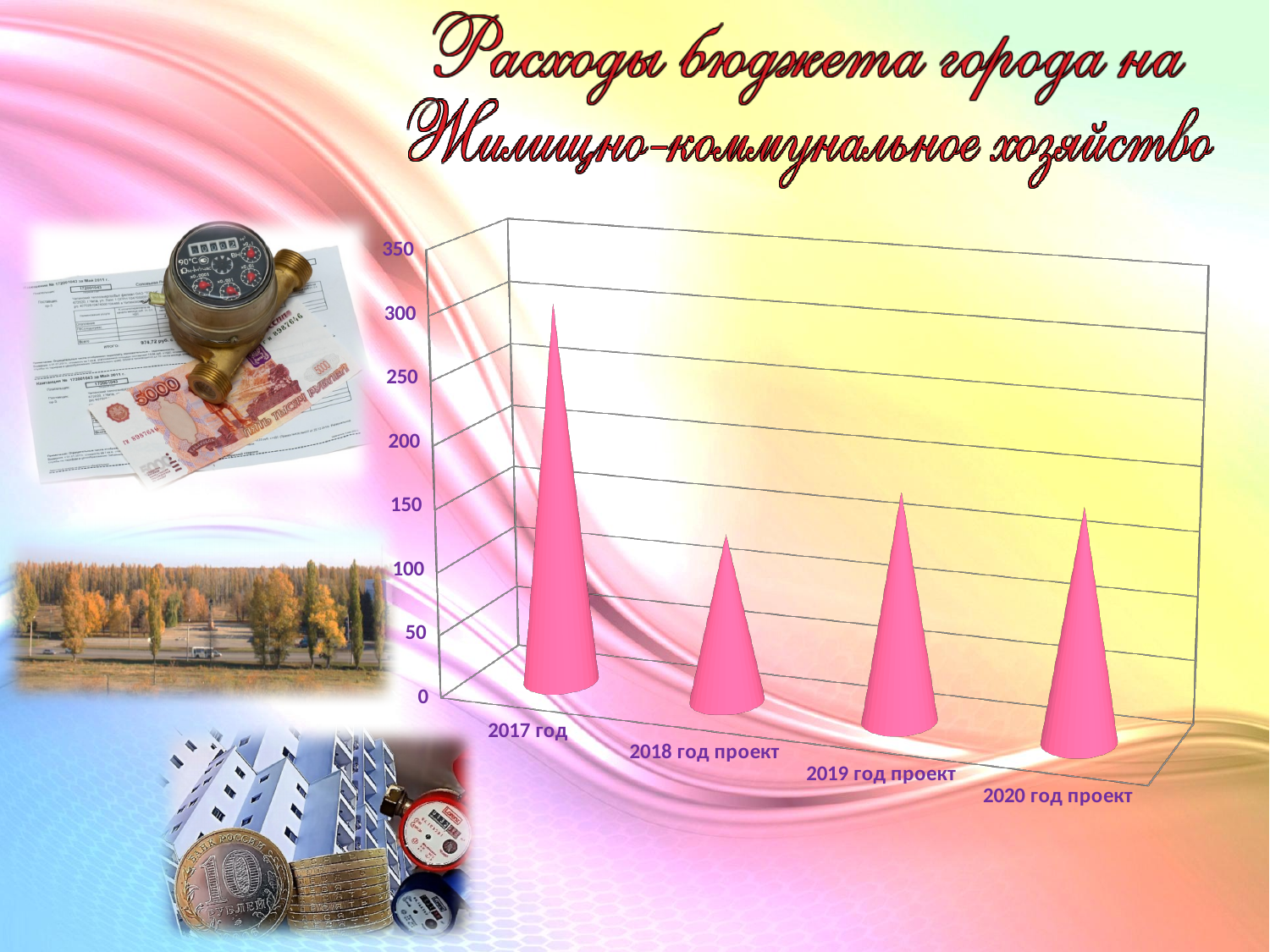
What kind of chart is shown on the slide? bar chart Which category has the lowest value on the chart? 2018 год проект What is the title of the slide above the chart? Расходы бюджета города на Жилищно-коммунальное хозяйство Is the value for 2017 год greater or less than 200? greater Which is larger, the value for 2017 год or for 2018 год проект? 2017 год Is the value for 2019 год проект greater or less than 100? greater Does the value rise or fall from 2017 год to 2018 год проект? fall Is the value for 2018 год проект greater or less than 200? less Which is larger, the value for 2018 год проект or for 2019 год проект? 2019 год проект Which year has the highest value on the chart? 2017 год How many categories (years) are plotted on the chart? 4